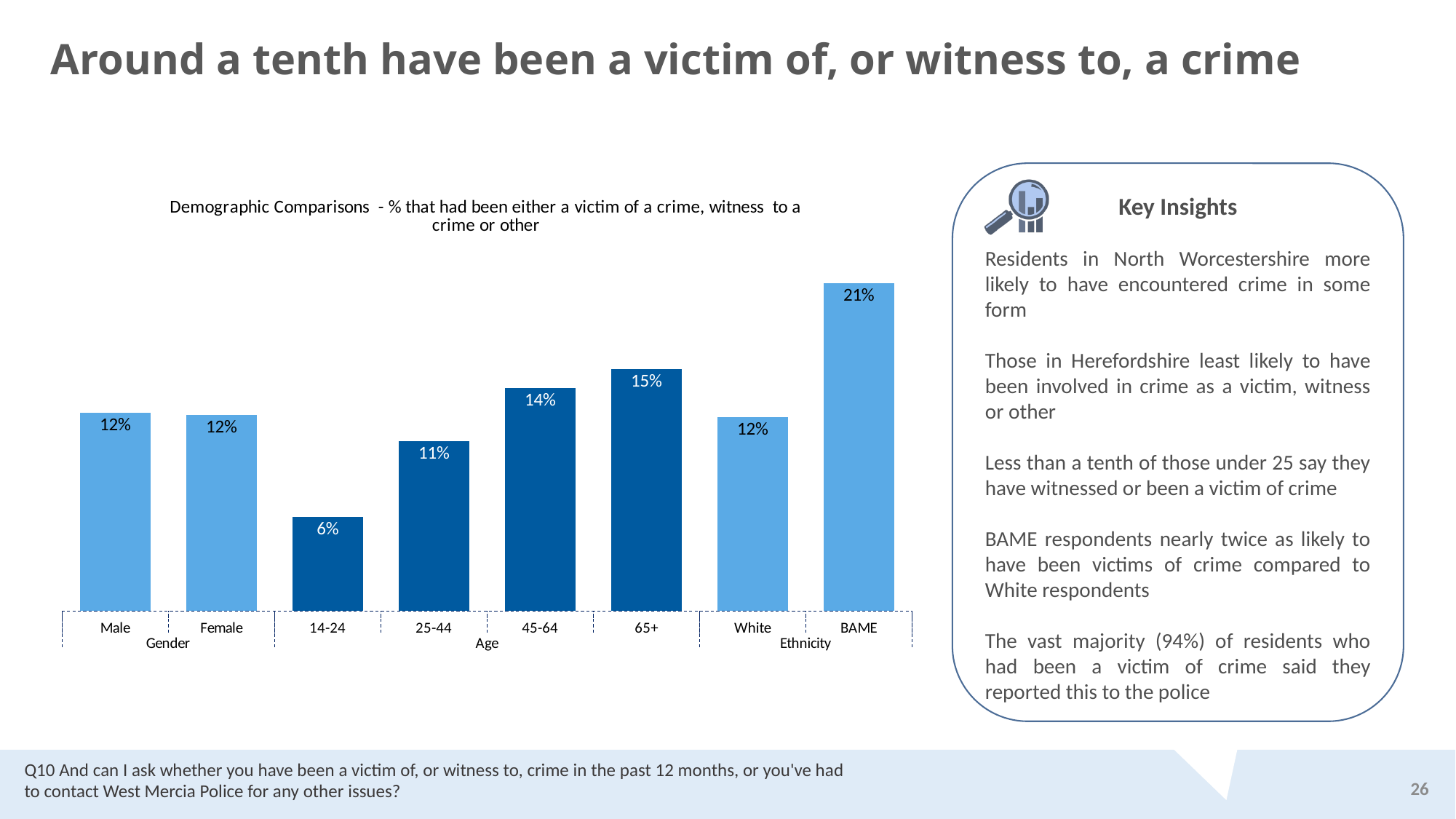
Which category has the highest value in the chart? BAME What is the difference between the 65+ and 14-24 values? 9% Which is larger, the value for 45-64 or the value for 25-44? 45-64 What percentage of BAME respondents had been a victim of, witness to, a crime or other? 21% What is the value shown for the 14-24 age group? 6% How many bars are plotted in the chart? 8 Do the values rise or fall across the age groups from 14-24 to 65+? rise What is the difference between the BAME and White values? 9% What is the value for Female respondents? 12% What type of chart is shown on the slide? bar chart Which category has the lowest value in the chart? 14-24 What percentage is shown for the 65+ age group? 15%